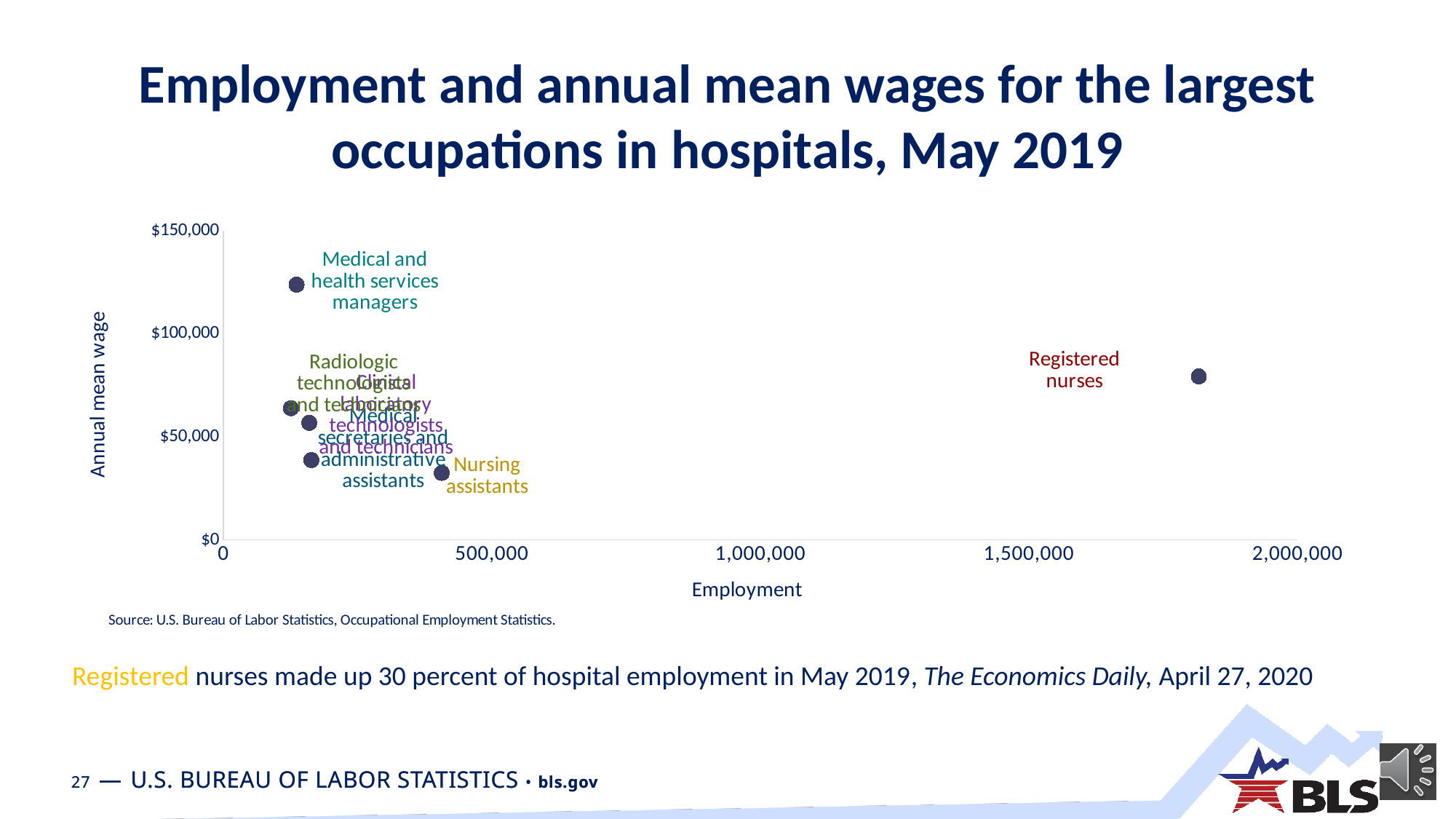
What kind of chart is shown on the slide? scatter chart Is the employment for Nursing assistants greater or less than 500,000? less Is the annual mean wage for Nursing assistants greater or less than $50,000? less Which occupation has the highest annual mean wage on the chart? Medical and health services managers What is the title of the horizontal axis of the chart? Employment Is the employment for Registered nurses greater or less than 1,500,000? greater Which occupation has the highest employment on the chart? Registered nurses Which has higher employment, Registered nurses or Nursing assistants? Registered nurses Which has a higher annual mean wage, Medical and health services managers or Registered nurses? Medical and health services managers How many occupations are plotted as points on the chart? 6